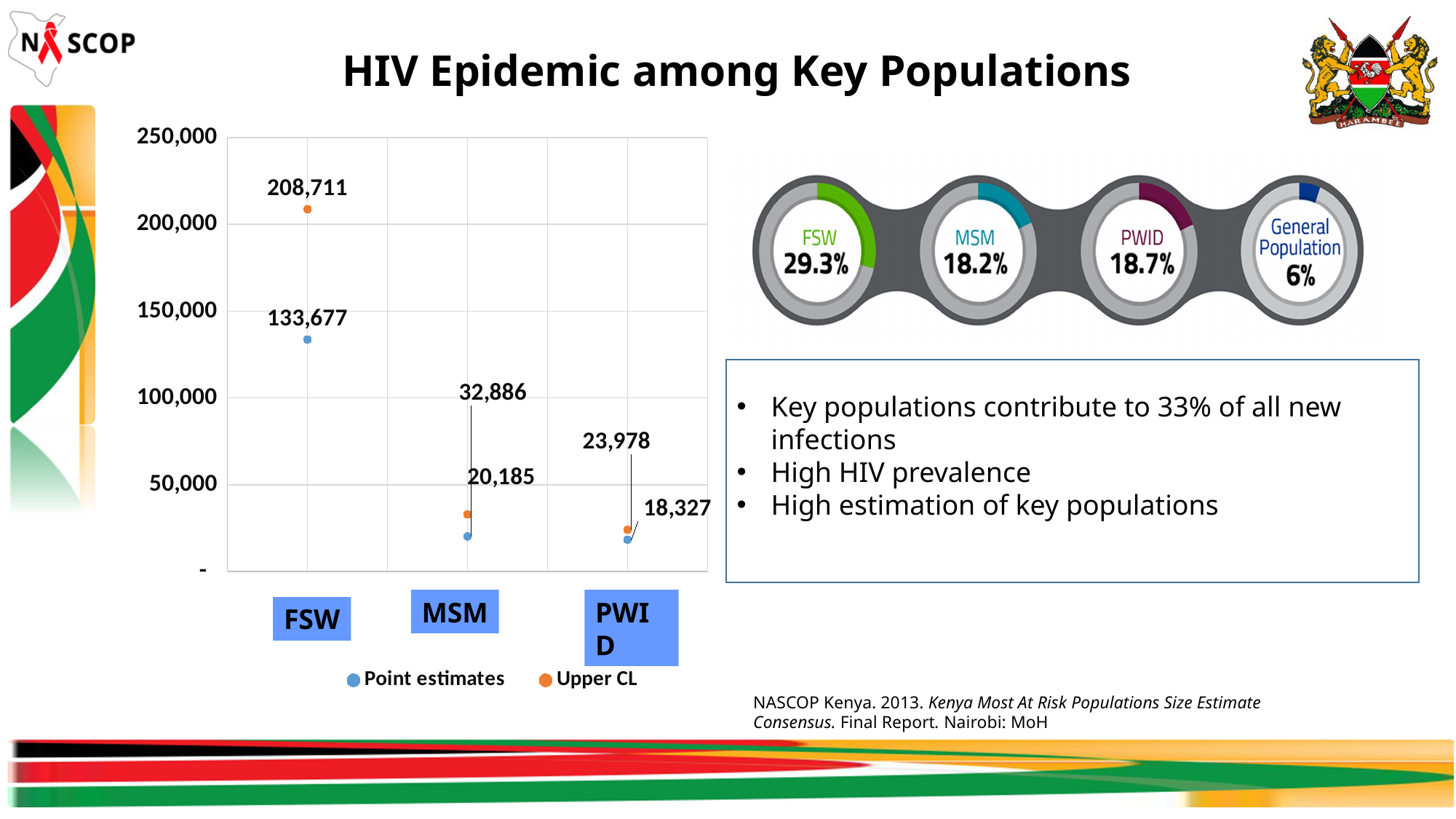
How many series does the chart legend list? 2 How many key populations are shown on the x axis of the chart? 3 What kind of chart is used to show the population size estimates? Scatter (dot) chart What is the Upper CL value for FSW? 208,711 What is the difference between the Upper CL and the point estimate for FSW? 75,034 What is the point estimate for FSW? 133,677 Which key population has the lowest Upper CL value? PWID What is the point estimate for MSM? 20,185 What is the Upper CL value for PWID? 23,978 What is the difference between the Upper CL and the point estimate for MSM? 12,701 Which key population has the highest point estimate? FSW Which is larger, the point estimate for MSM or the point estimate for PWID? MSM